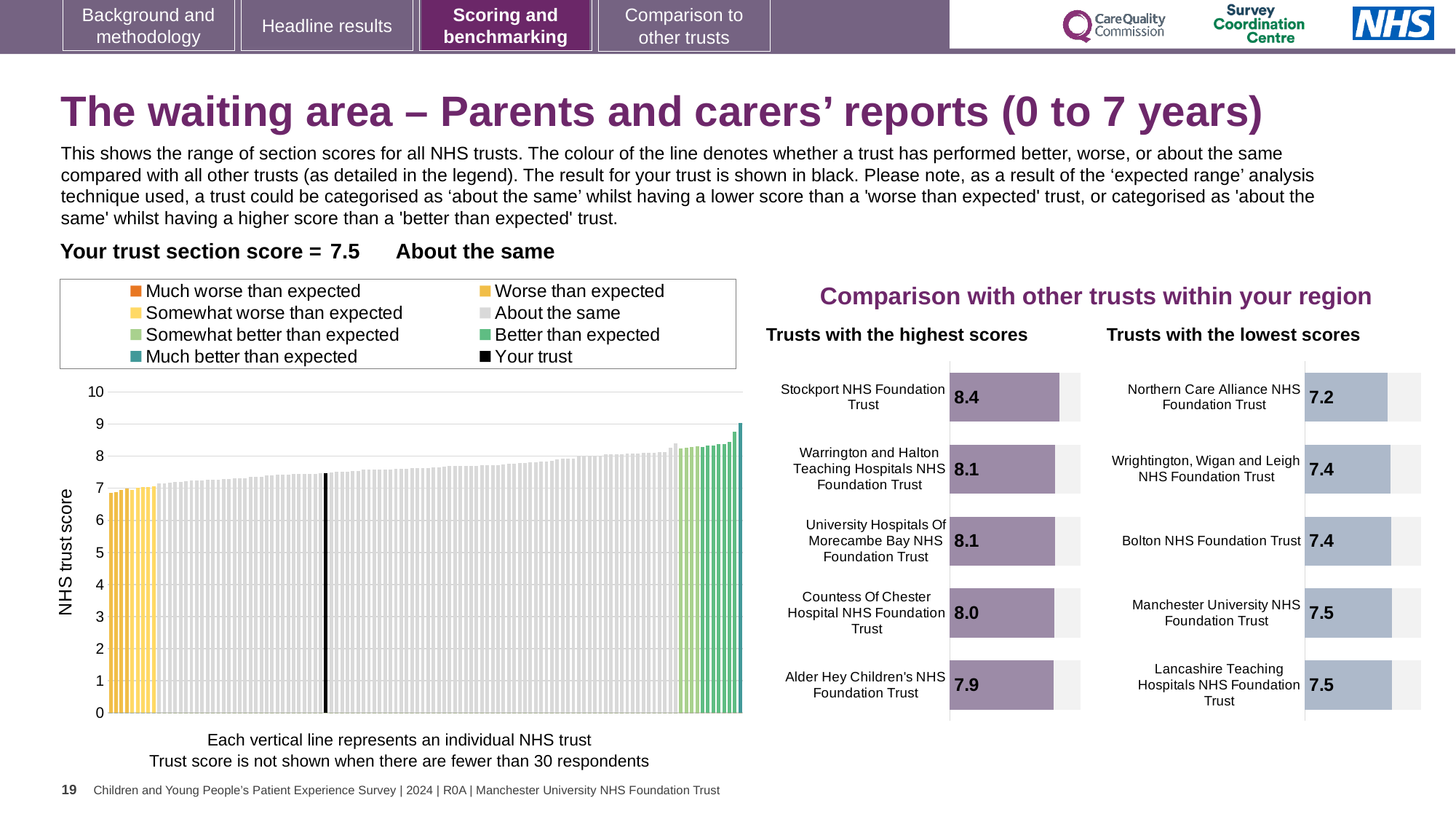
In the 'Trusts with the lowest scores' chart, which is larger: the score for Bolton NHS Foundation Trust or the score for Northern Care Alliance NHS Foundation Trust? Bolton NHS Foundation Trust In the 'Trusts with the highest scores' chart, which trust has the lowest score? Alder Hey Children's NHS Foundation Trust In the 'Trusts with the lowest scores' chart, what is the score for Northern Care Alliance NHS Foundation Trust? 7.2 In the chart on the left, is the value of the tallest bar greater or less than 8? greater How many entries does the legend above the chart on the left list? 8 In the 'Trusts with the highest scores' chart, what is the score for Stockport NHS Foundation Trust? 8.4 What kind of chart is the large chart on the left showing NHS trust scores? bar chart In the chart on the left, is the value of the black bar (your trust) greater or less than 5? greater In the 'Trusts with the lowest scores' chart, which trust has the lowest score? Northern Care Alliance NHS Foundation Trust In the chart on the left, what is the label on the vertical axis? NHS trust score In the 'Trusts with the highest scores' chart, how many trusts are shown? 5 In the 'Trusts with the highest scores' chart, what is the difference between the scores of Stockport NHS Foundation Trust and Alder Hey Children's NHS Foundation Trust? 0.5